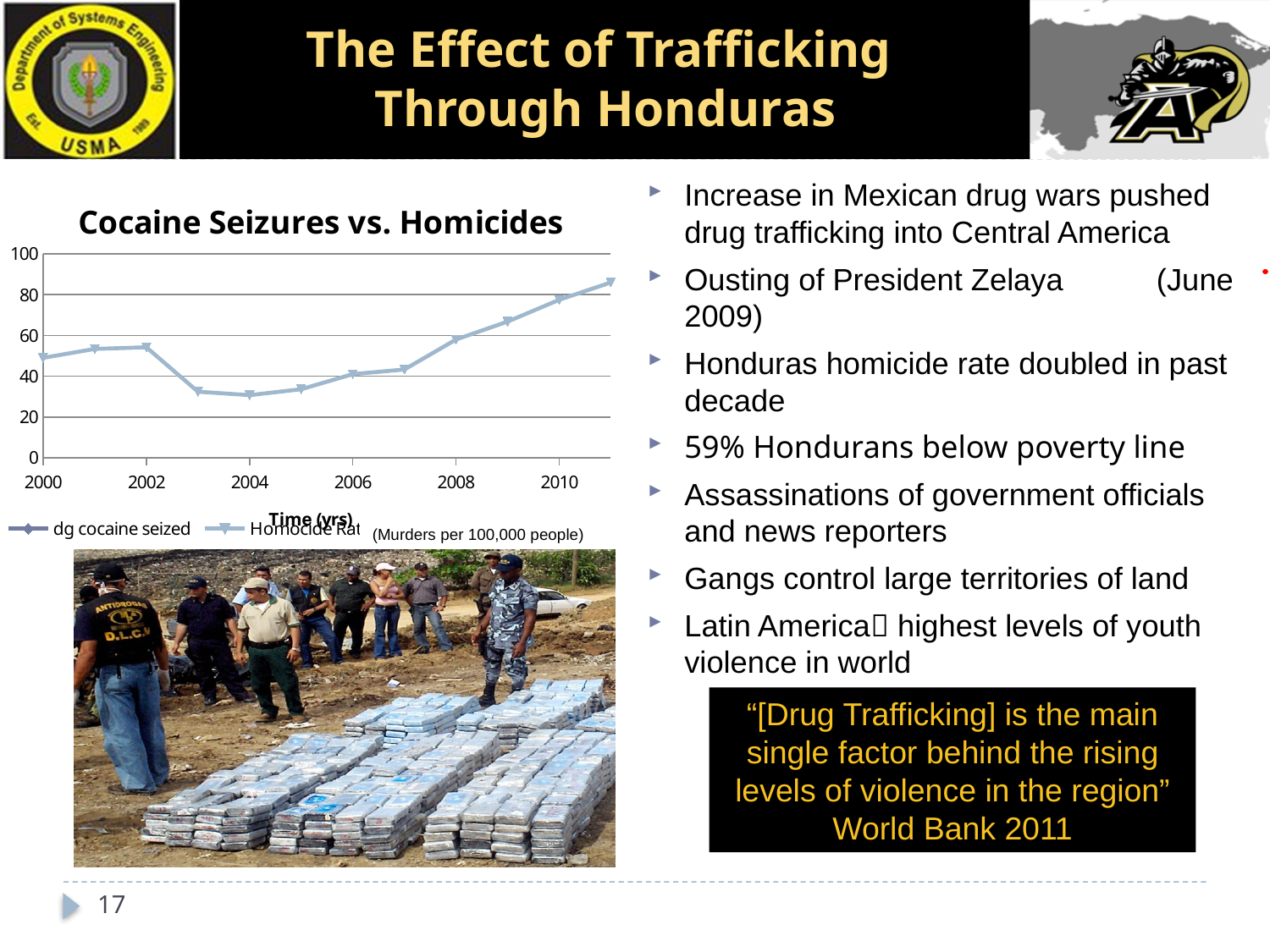
How many series does the legend of the "Cocaine Seizures vs. Homicides" chart list? 2 In the "Cocaine Seizures vs. Homicides" chart, do the values rise or fall from 2004 to 2011? rise What is the x-axis title of the "Cocaine Seizures vs. Homicides" chart? Time (yrs) In the "Cocaine Seizures vs. Homicides" chart, is the value for 2011 greater or less than 80? greater In the "Cocaine Seizures vs. Homicides" chart, which is larger, the value for 2002 or the value for 2004? 2002 In the "Cocaine Seizures vs. Homicides" chart, which is larger, the value for 2000 or the value for 2011? 2011 In the "Cocaine Seizures vs. Homicides" chart, which year has the highest plotted value? 2011 In the "Cocaine Seizures vs. Homicides" chart, is the value for 2004 greater or less than 40? less What kind of chart is "Cocaine Seizures vs. Homicides"? line chart What is the title of the chart on the slide? Cocaine Seizures vs. Homicides In the "Cocaine Seizures vs. Homicides" chart, is the value for 2000 greater or less than 40? greater